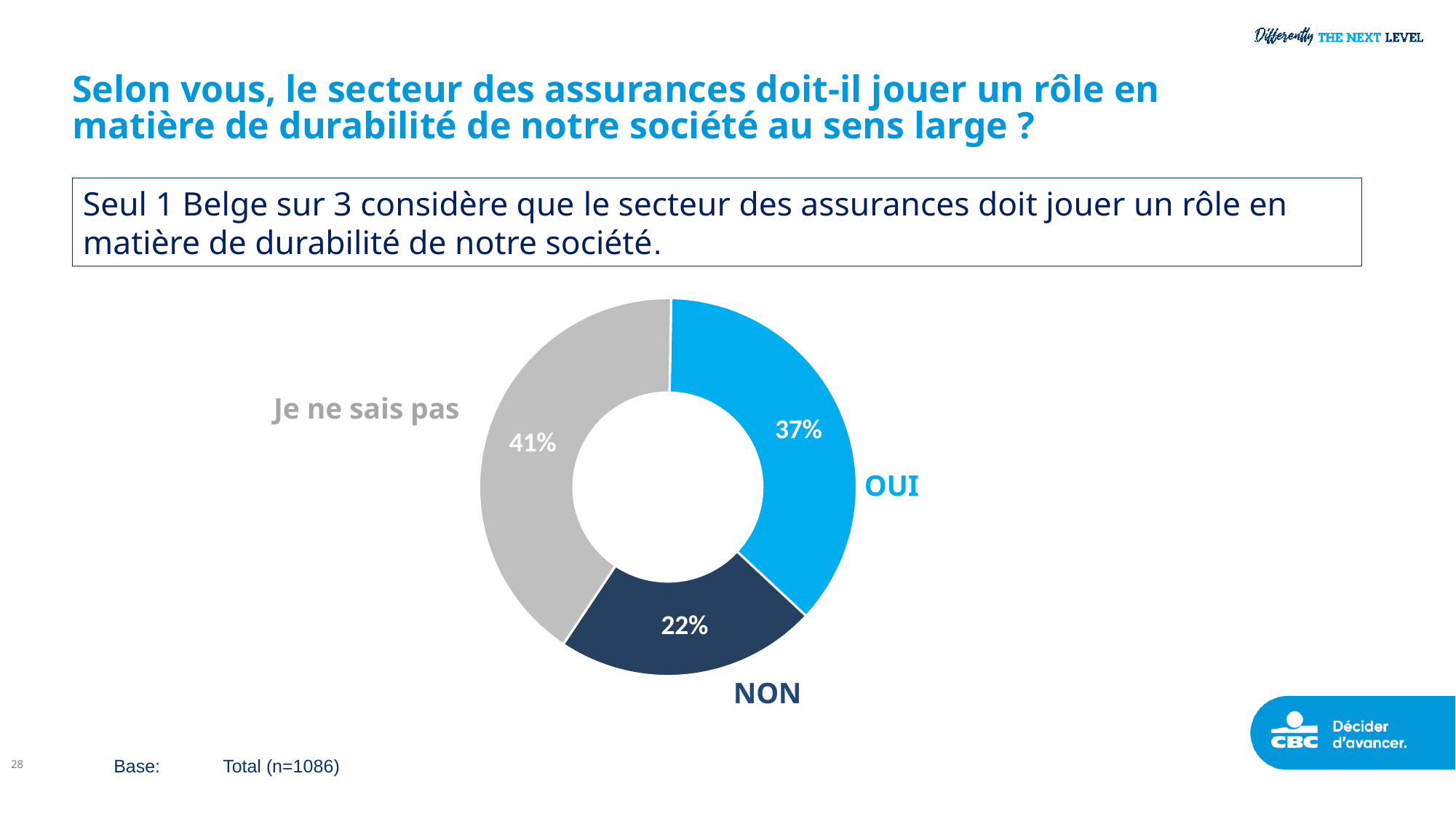
Which response has the smallest share of the pie? NON What is the base sample size stated at the bottom of the slide? Total (n=1086) How many response categories are shown in the chart? 3 What percentage of respondents answered OUI? 37% Which is larger, the share for OUI or the share for NON? OUI What percentage of respondents answered NON? 22% What colour is the OUI slice? Light blue Which response has the largest share of the pie? Je ne sais pas What kind of chart is shown on the slide? Pie chart (doughnut) What is the difference in percentage points between Je ne sais pas and OUI? 4 What is the difference in percentage points between OUI and NON? 15 What percentage of respondents answered Je ne sais pas? 41%